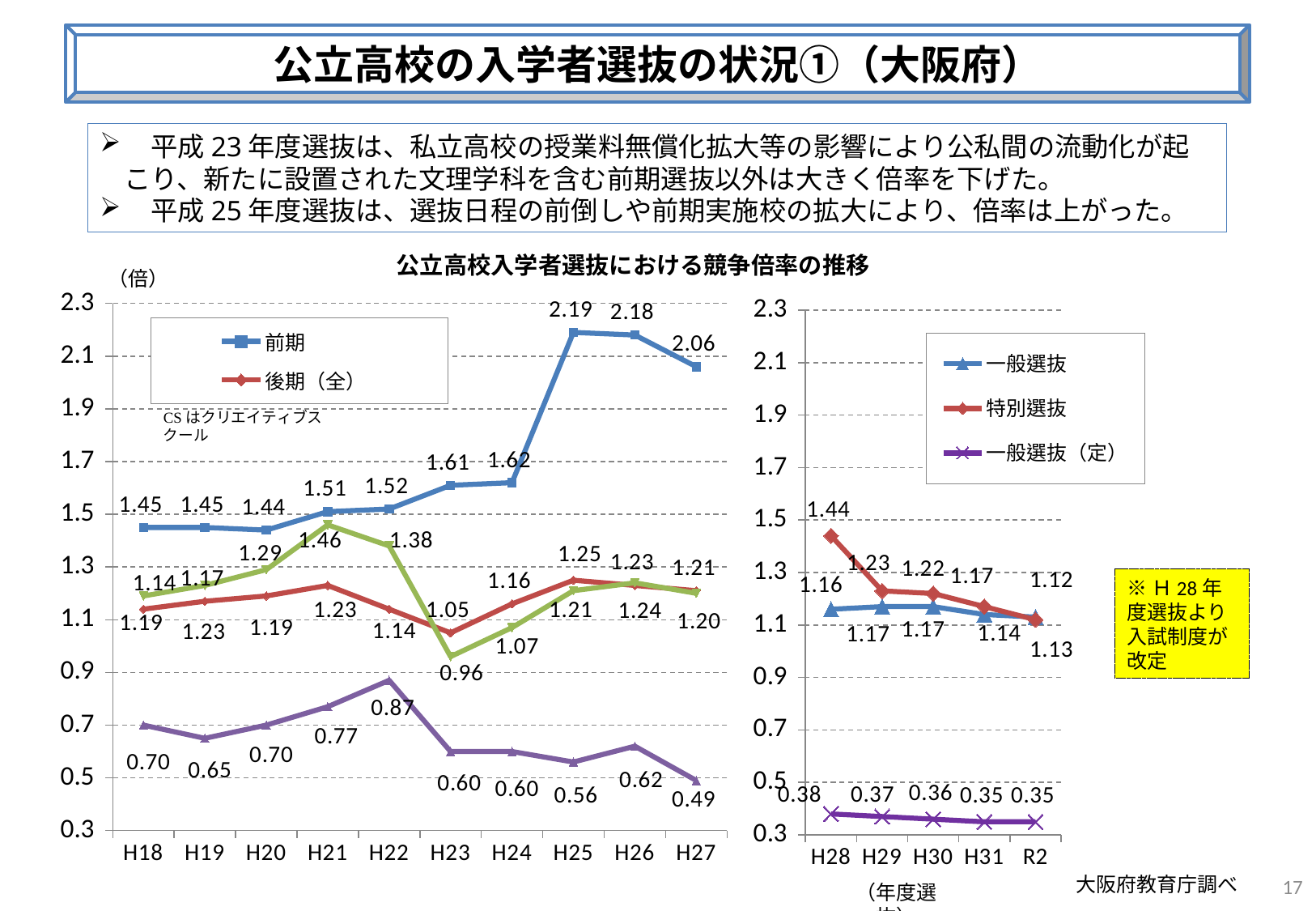
In the left chart (公立高校入学者選抜における競争倍率の推移), what is the value of 前期 for H25? 2.19 In the right chart, does the 特別選抜 value rise or fall from H28 to R2? fall How many series does the legend of the right chart list? 3 In the right chart, what is the value of 特別選抜 for H28? 1.44 In the right chart, what is the value of 一般選抜（定） for R2? 0.35 In the left chart, what is the difference between the 前期 values for H25 and H24? 0.57 In the left chart, is the 前期 value for H18 greater or less than 1.5? less In the left chart, in which year is the 前期 value highest? H25 What kind of chart is the right chart? line chart In the right chart, which is larger for H28: 特別選抜 or 一般選抜? 特別選抜 What is the title of the left chart? 公立高校入学者選抜における競争倍率の推移 In the left chart, how many years are shown on the x axis? 10